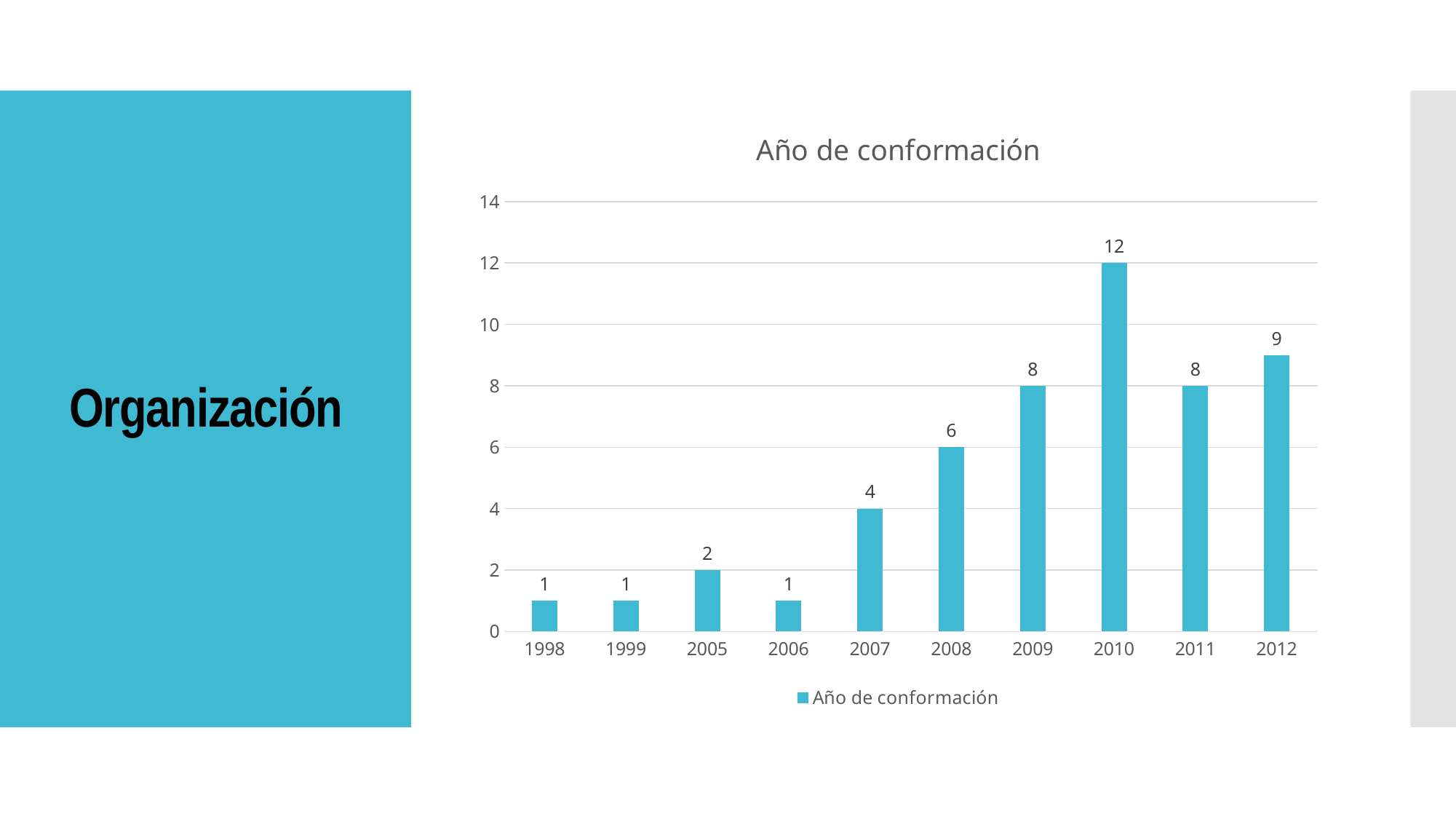
Which year has the highest value? 2010 What is the value for 2007? 4 What is the value for 2010? 12 How many series does the legend list? 1 Which is larger, the value for 2009 or the value for 2008? 2009 What kind of chart is shown? bar chart What is the difference between the values for 2010 and 2011? 4 Is the value for 2010 greater or less than 10? greater What is the difference between the values for 2008 and 2005? 4 What is the value for 2012? 9 How many years are shown on the x axis? 10 What is the title of the chart? Año de conformación